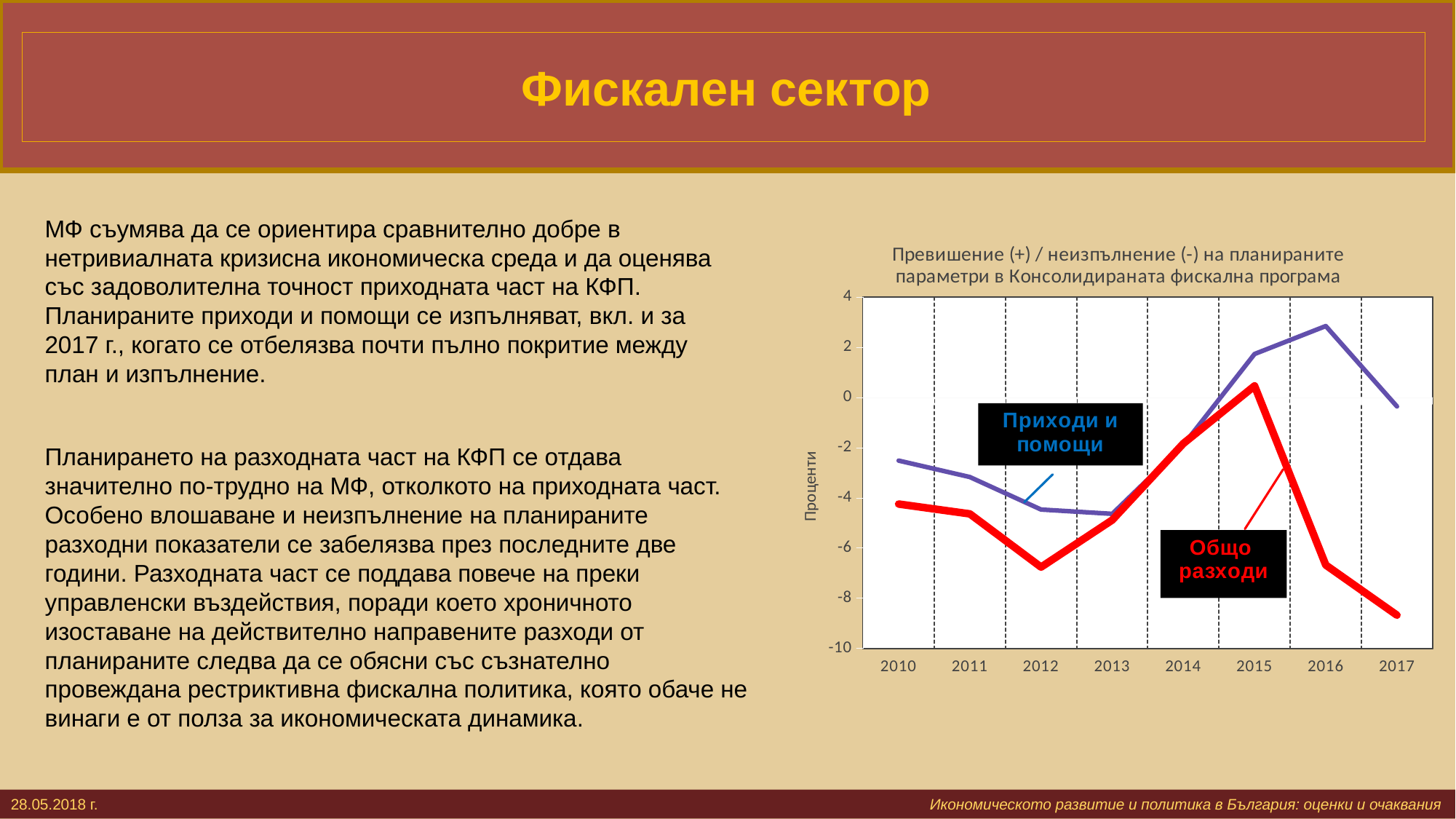
How many years are plotted along the x axis of the chart? 8 In which year does the series 'Общо разходи' reach its highest value? 2015 Is the value for 'Общо разходи' in 2012 greater or less than -6? less What is the label of the y axis of the chart? Проценти Which series is drawn in red? Общо разходи Is the value for 'Общо разходи' in 2017 greater or less than -8? less Is the value for 'Приходи и помощи' in 2016 greater or less than 2? greater How many series are plotted in the chart? 2 What kind of chart is shown on the slide? line chart In 2017, which series has the higher value, 'Приходи и помощи' or 'Общо разходи'? Приходи и помощи In which year does the series 'Общо разходи' reach its lowest value? 2017 In which year does the series 'Приходи и помощи' reach its highest value? 2016